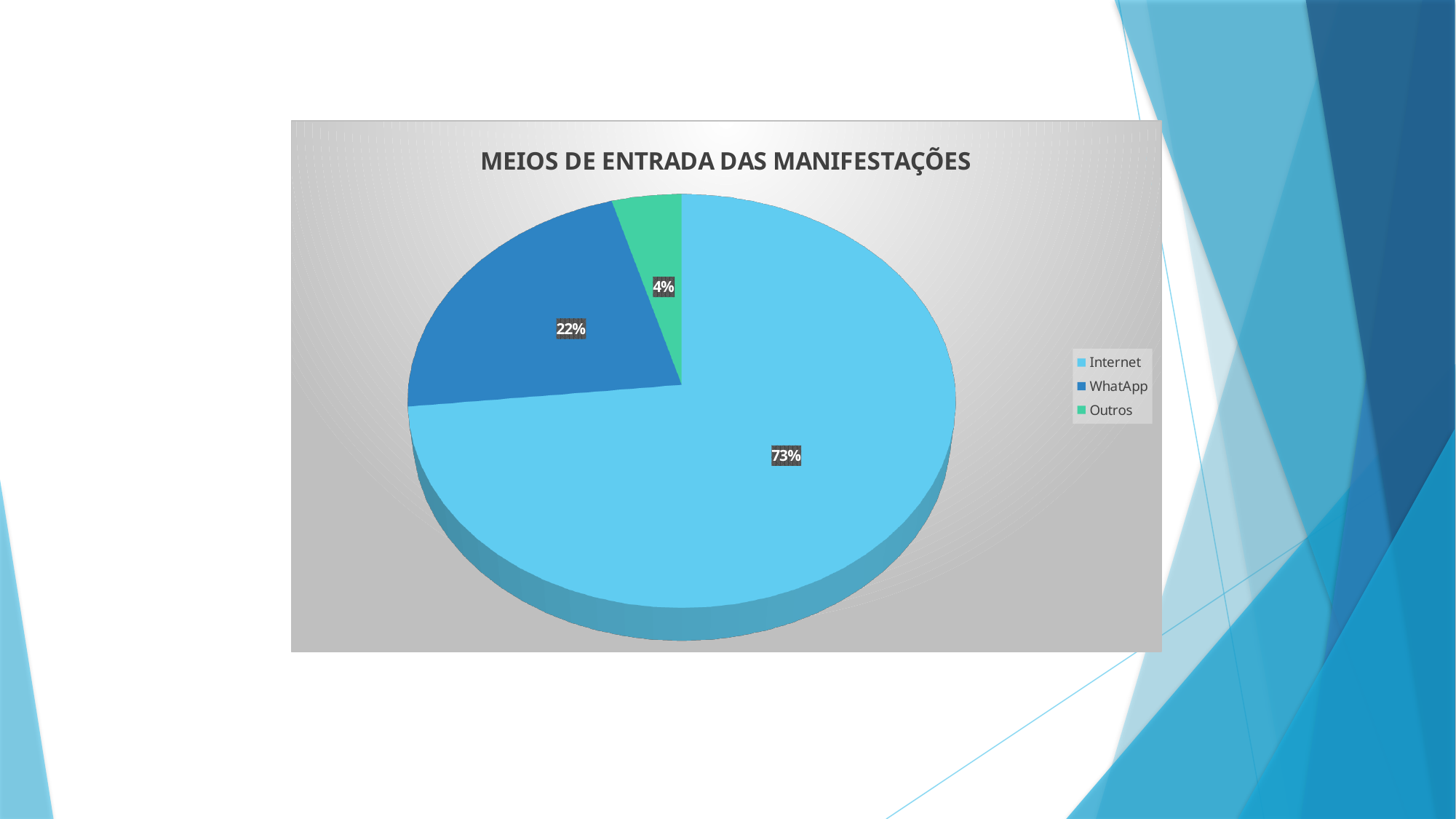
What kind of chart is shown on the slide? pie chart Which is larger, the WhatApp slice or the Outros slice? WhatApp What share of the pie does Outros represent? 4% What share of the pie does WhatApp represent? 22% Which category has the largest slice of the pie? Internet What is the title of the chart? MEIOS DE ENTRADA DAS MANIFESTAÇÕES What share of the pie does Internet represent? 73% What colour is the Outros slice? green How many entries does the legend list? 3 What is the difference in percentage points between the Internet slice and the WhatApp slice? 51 Which category has the smallest slice of the pie? Outros How many slices does the pie chart have? 3